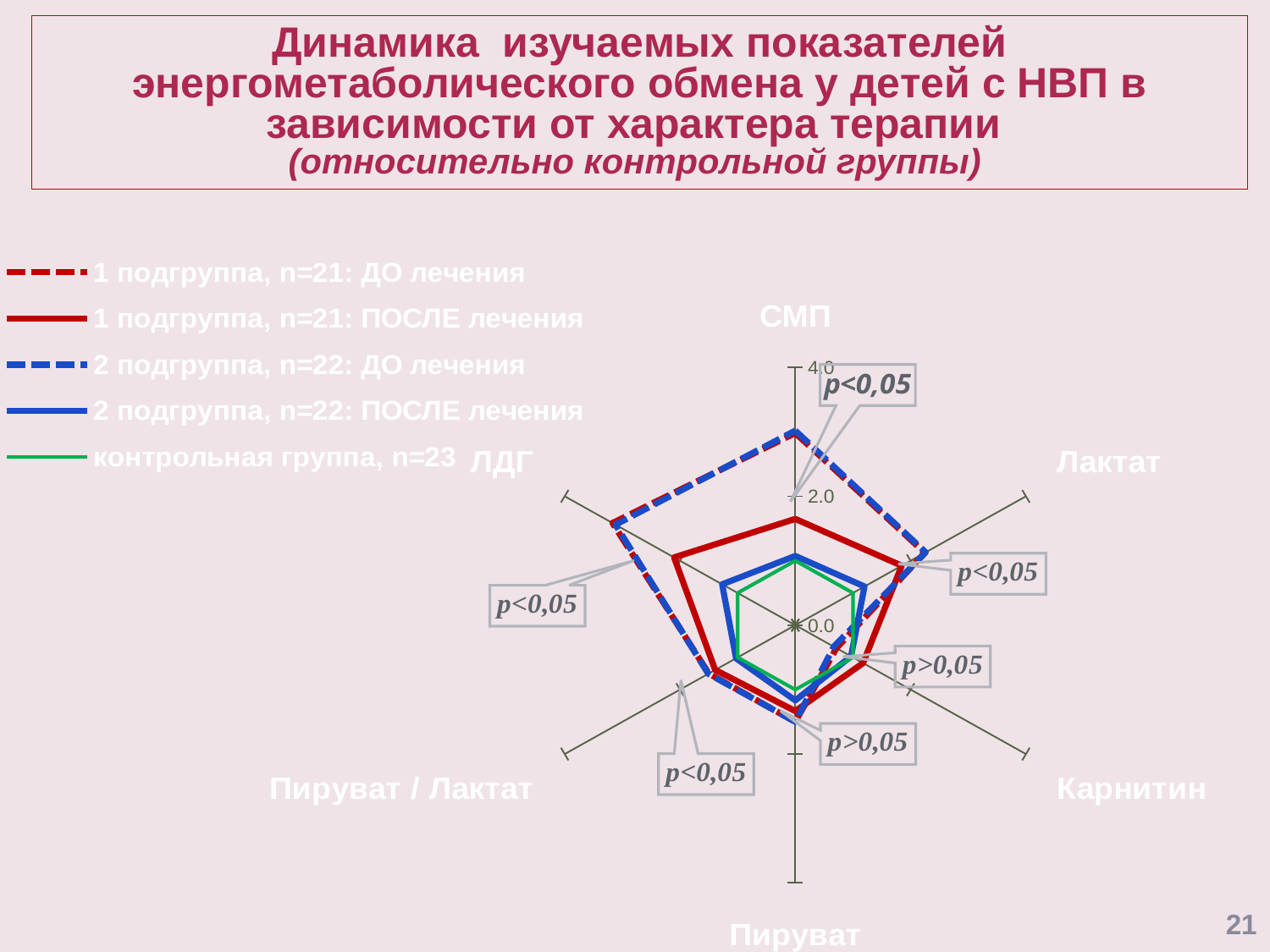
Is the value for ЛДГ in the series '2 подгруппа, n=22: ДО лечения' greater or less than 2.0? greater Is the value for Карнитин in the series 'контрольная группа, n=23' greater or less than 2.0? less For СМП, which is larger: the value for '1 подгруппа, n=21: ДО лечения' or for '1 подгруппа, n=21: ПОСЛЕ лечения'? 1 подгруппа, n=21: ДО лечения For Лактат, which is larger: the value for '2 подгруппа, n=22: ДО лечения' or for 'контрольная группа, n=23'? 2 подгруппа, n=22: ДО лечения How many series does the legend list? 5 What colour is the line for the контрольная группа, n=23? green How many axes (indicators) does the radar chart have? 6 Is the value for СМП in the series 'контрольная группа, n=23' greater or less than 2.0? less For ЛДГ, which is larger: the value for '1 подгруппа, n=21: ПОСЛЕ лечения' or for '2 подгруппа, n=22: ПОСЛЕ лечения'? 1 подгруппа, n=21: ПОСЛЕ лечения Which indicator is plotted on the axis pointing straight up? СМП What kind of chart is shown on the slide? radar chart